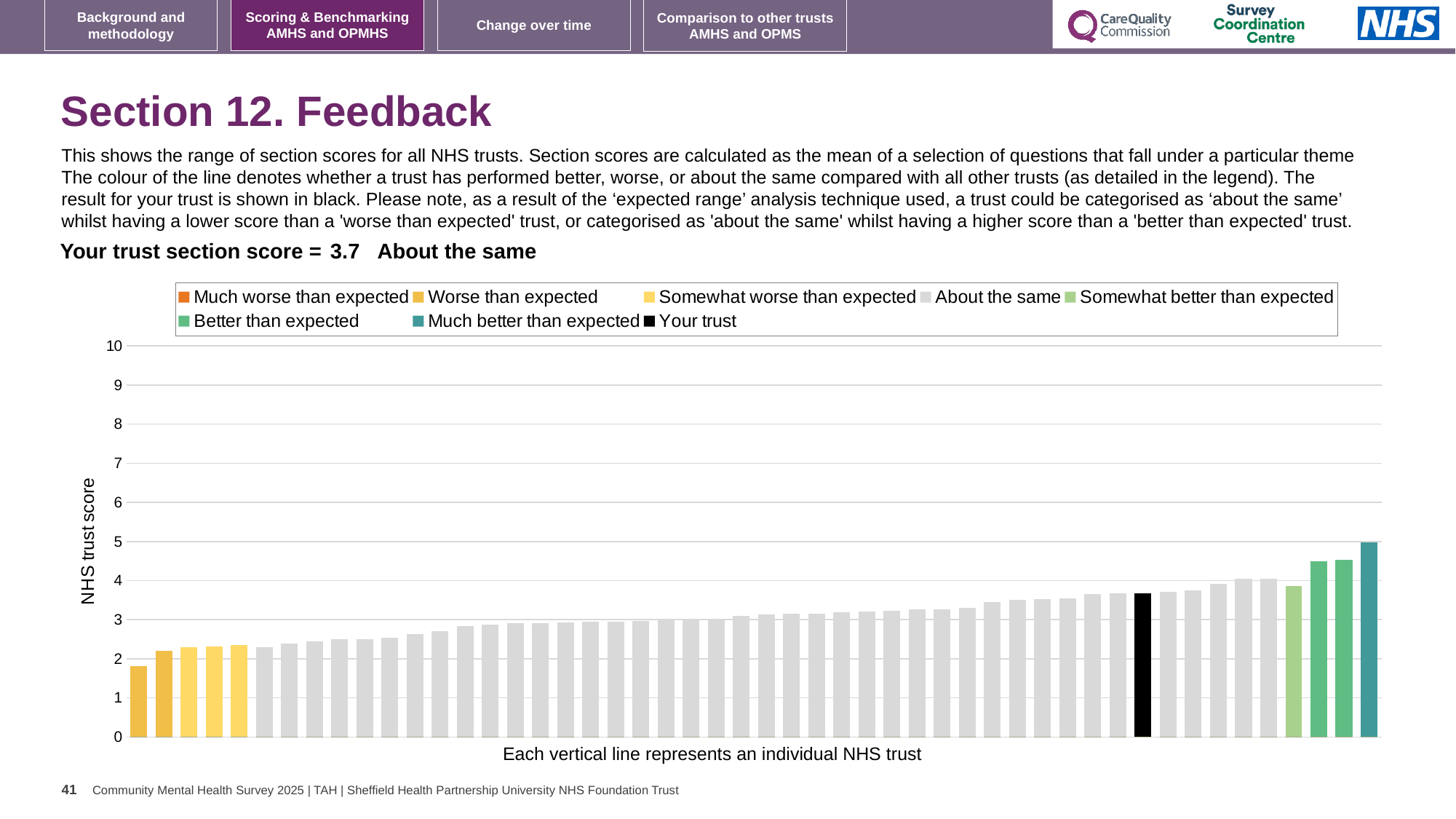
Which legend category does the shortest bar belong to? Worse than expected What is the section score for your trust, as printed on the slide? 3.7 Is the value of the leftmost (lowest) bar greater or less than 2? less What is the label on the y axis of the chart? NHS trust score Which legend category does the tallest bar belong to? Much better than expected How many bars are coloured as 'Somewhat worse than expected' (light yellow)? 3 How many bars are coloured as 'Better than expected' (mid green)? 2 How many entries does the chart legend list? 8 What kind of chart is shown on the slide? bar chart Is the value for your trust (the black bar) greater or less than 3? greater Is the value of the rightmost (tallest) bar greater or less than 4? greater Do the bar values rise or fall from left to right along the x axis? rise